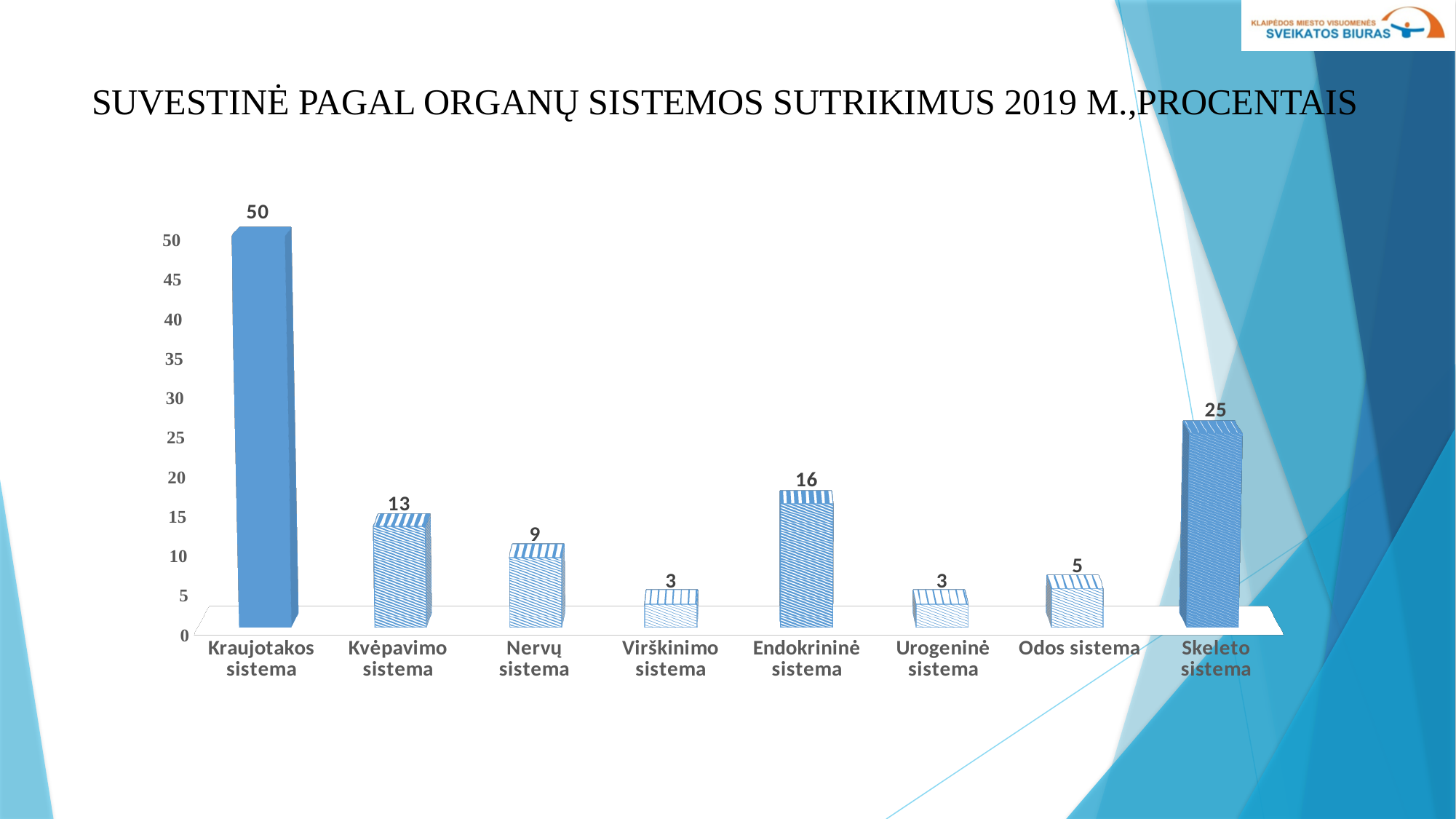
What is the title of the chart? SUVESTINĖ PAGAL ORGANŲ SISTEMOS SUTRIKIMUS 2019 M.,PROCENTAIS What is the value for Kraujotakos sistema? 50 What is the difference between the values for Kvėpavimo sistema and Nervų sistema? 4 Which category has the highest value? Kraujotakos sistema How many categories are shown on the x axis? 8 What is the value for Skeleto sistema? 25 What is the value for Odos sistema? 5 Is the value for Skeleto sistema greater or less than 20? greater What kind of chart is shown on the slide? bar chart Which is larger, the value for Endokrininė sistema or the value for Kvėpavimo sistema? Endokrininė sistema What is the value for Endokrininė sistema? 16 What is the difference between the values for Kraujotakos sistema and Skeleto sistema? 25